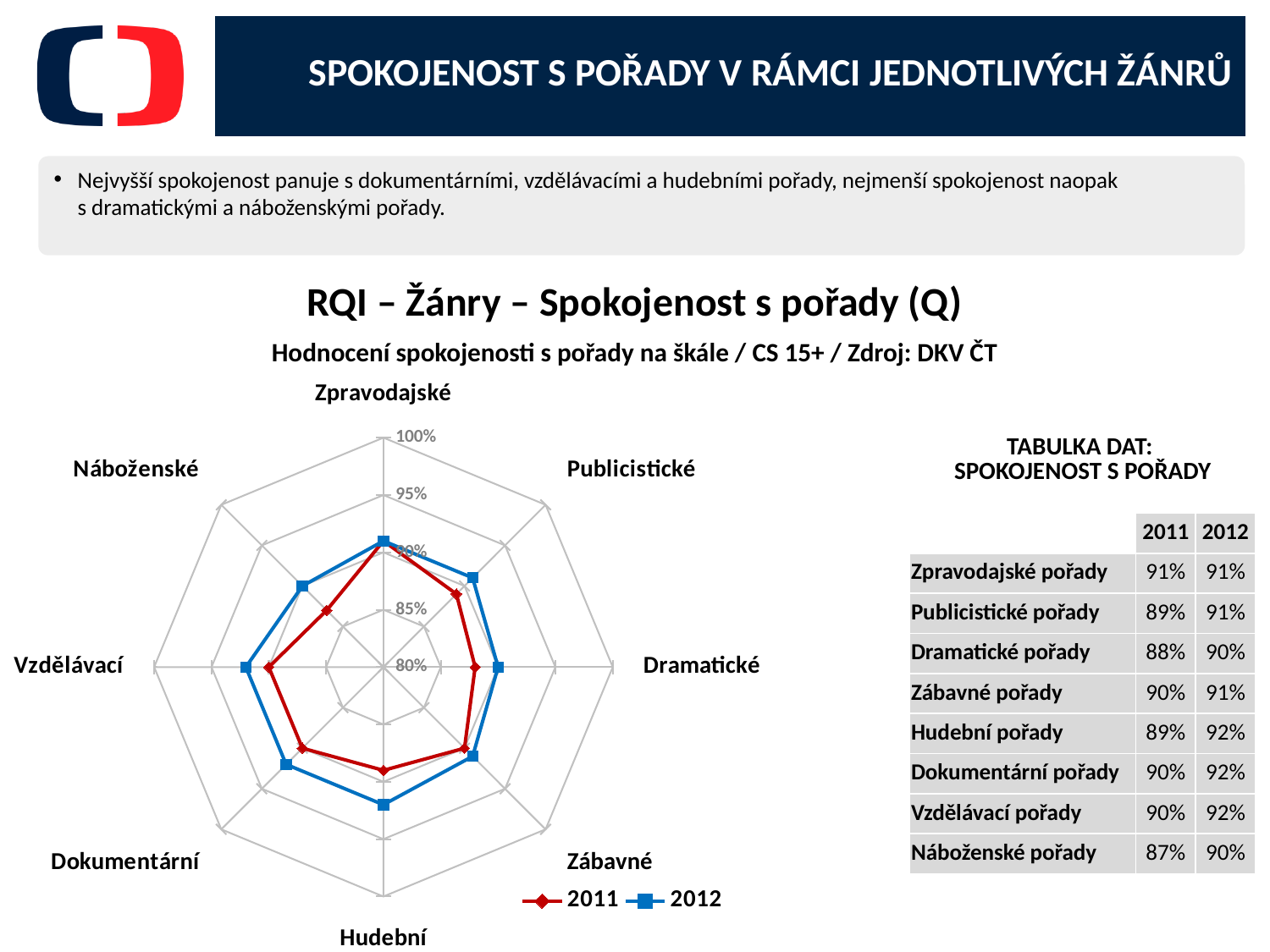
Which is larger: the 2012 value for Hudební pořady or the 2012 value for Dramatické pořady? Hudební pořady What kind of chart is shown on the slide? Radar chart According to the data table, what was the satisfaction with Hudební pořady in 2012? 92% Which genre had the highest satisfaction in 2011 according to the data table? Zpravodajské pořady How many genre categories are plotted on the radar chart? 8 Which colour represents the 2012 series on the radar chart? Blue What is the difference between the 2012 and 2011 satisfaction values for Náboženské pořady? 3% Is the 2011 value for Náboženské pořady greater or less than 90%? less Which genre had the lowest satisfaction in 2011 according to the data table? Náboženské pořady How many series does the chart legend list? 2 According to the data table, what was the satisfaction with Náboženské pořady in 2011? 87% According to the data table, what was the satisfaction with Dramatické pořady in 2012? 90%